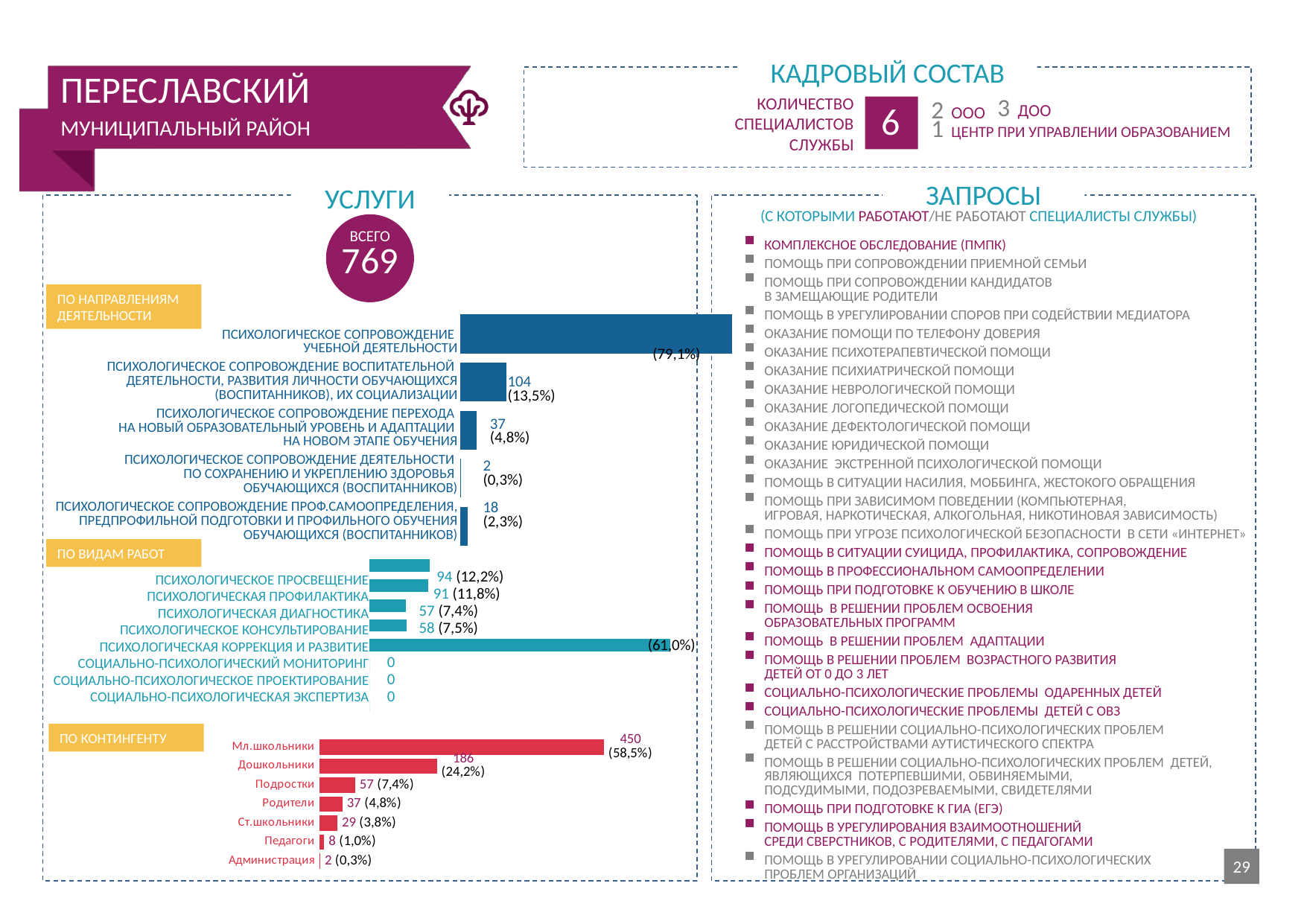
In the 'ПО ВИДАМ РАБОТ' chart, what is the value for ПСИХОЛОГИЧЕСКОЕ ПРОСВЕЩЕНИЕ? 94 How many categories are shown in the 'ПО ВИДАМ РАБОТ' chart? 8 In the 'ПО КОНТИНГЕНТУ' chart, which category has the lowest value? Администрация How many categories are shown in the 'ПО КОНТИНГЕНТУ' chart? 7 What type of chart is the 'ПО КОНТИНГЕНТУ' chart? Bar chart In the 'ПО КОНТИНГЕНТУ' chart, what is the difference between the values for Подростки and Родители? 20 In the 'ПО КОНТИНГЕНТУ' chart, what is the value for Дошкольники? 186 In the 'ПО НАПРАВЛЕНИЯМ ДЕЯТЕЛЬНОСТИ' chart, what percentage is shown for ПСИХОЛОГИЧЕСКОЕ СОПРОВОЖДЕНИЕ УЧЕБНОЙ ДЕЯТЕЛЬНОСТИ? 79,1% In the 'ПО ВИДАМ РАБОТ' chart, what is the difference between the values for ПСИХОЛОГИЧЕСКОЕ ПРОСВЕЩЕНИЕ and ПСИХОЛОГИЧЕСКАЯ ПРОФИЛАКТИКА? 3 In the 'ПО КОНТИНГЕНТУ' chart, what is the value for Мл.школьники? 450 In the 'ПО КОНТИНГЕНТУ' chart, which category has the highest value? Мл.школьники In the 'ПО НАПРАВЛЕНИЯМ ДЕЯТЕЛЬНОСТИ' chart, what is the value for ПСИХОЛОГИЧЕСКОЕ СОПРОВОЖДЕНИЕ ВОСПИТАТЕЛЬНОЙ ДЕЯТЕЛЬНОСТИ, РАЗВИТИЯ ЛИЧНОСТИ ОБУЧАЮЩИХСЯ (ВОСПИТАННИКОВ), ИХ СОЦИАЛИЗАЦИИ? 104